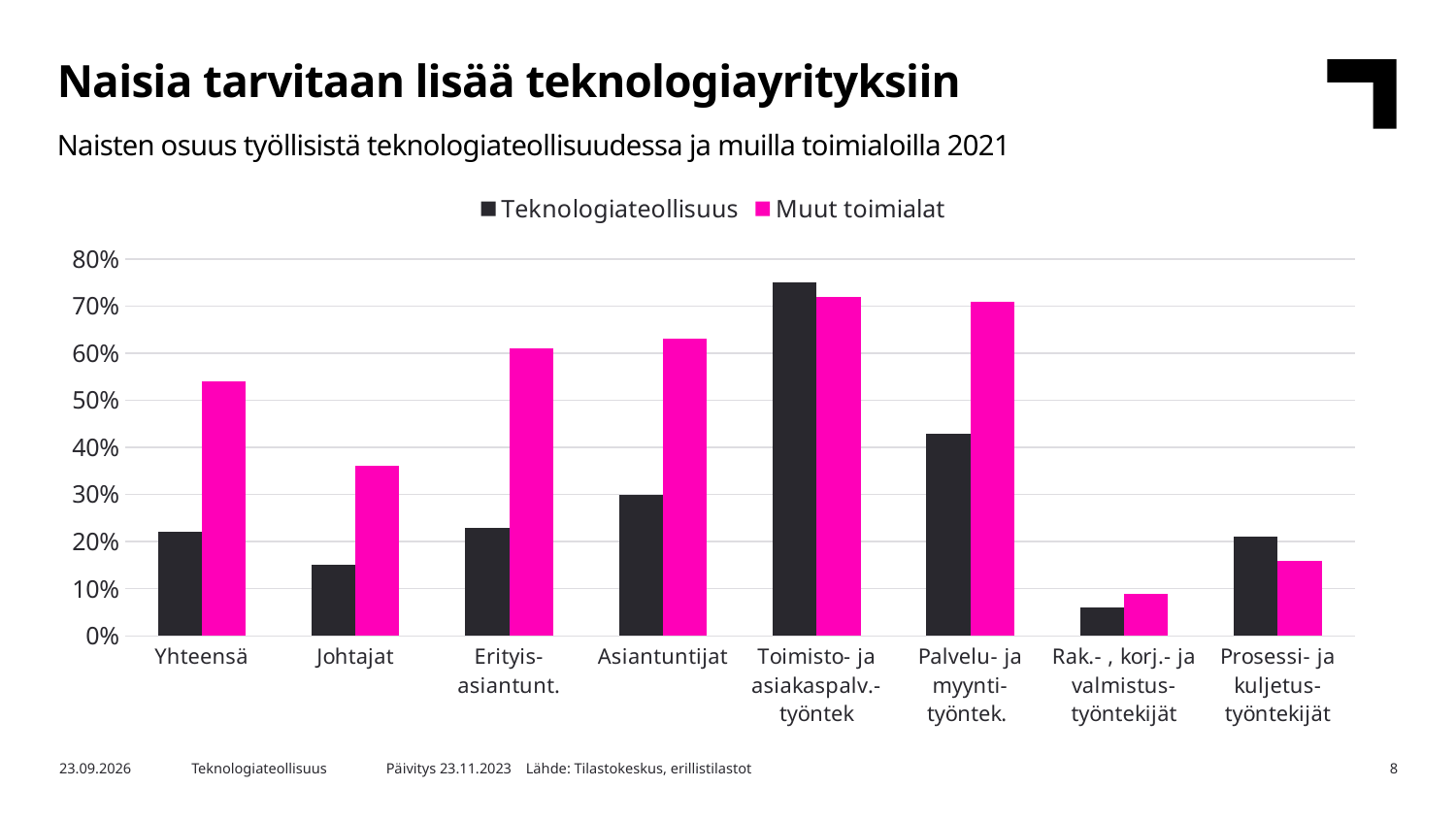
How many series does the legend list? 2 Which category has the lowest value for Teknologiateollisuus? Rak.- , korj.- ja valmistus-työntekijät Is the Teknologiateollisuus value for Johtajat greater or less than 20%? less What kind of chart is shown on the slide? bar chart How many categories are shown on the x axis? 8 Is the Teknologiateollisuus value for Toimisto- ja asiakaspalv.-työntek greater or less than 70%? greater Which category has the highest value for Teknologiateollisuus? Toimisto- ja asiakaspalv.-työntek Which colour represents the Muut toimialat series? magenta (pink) For Yhteensä, which series has the larger value, Teknologiateollisuus or Muut toimialat? Muut toimialat For Prosessi- ja kuljetus-työntekijät, which series has the larger value, Teknologiateollisuus or Muut toimialat? Teknologiateollisuus Is the Muut toimialat value for Yhteensä greater or less than 50%? greater Which category has the lowest value for Muut toimialat? Rak.- , korj.- ja valmistus-työntekijät